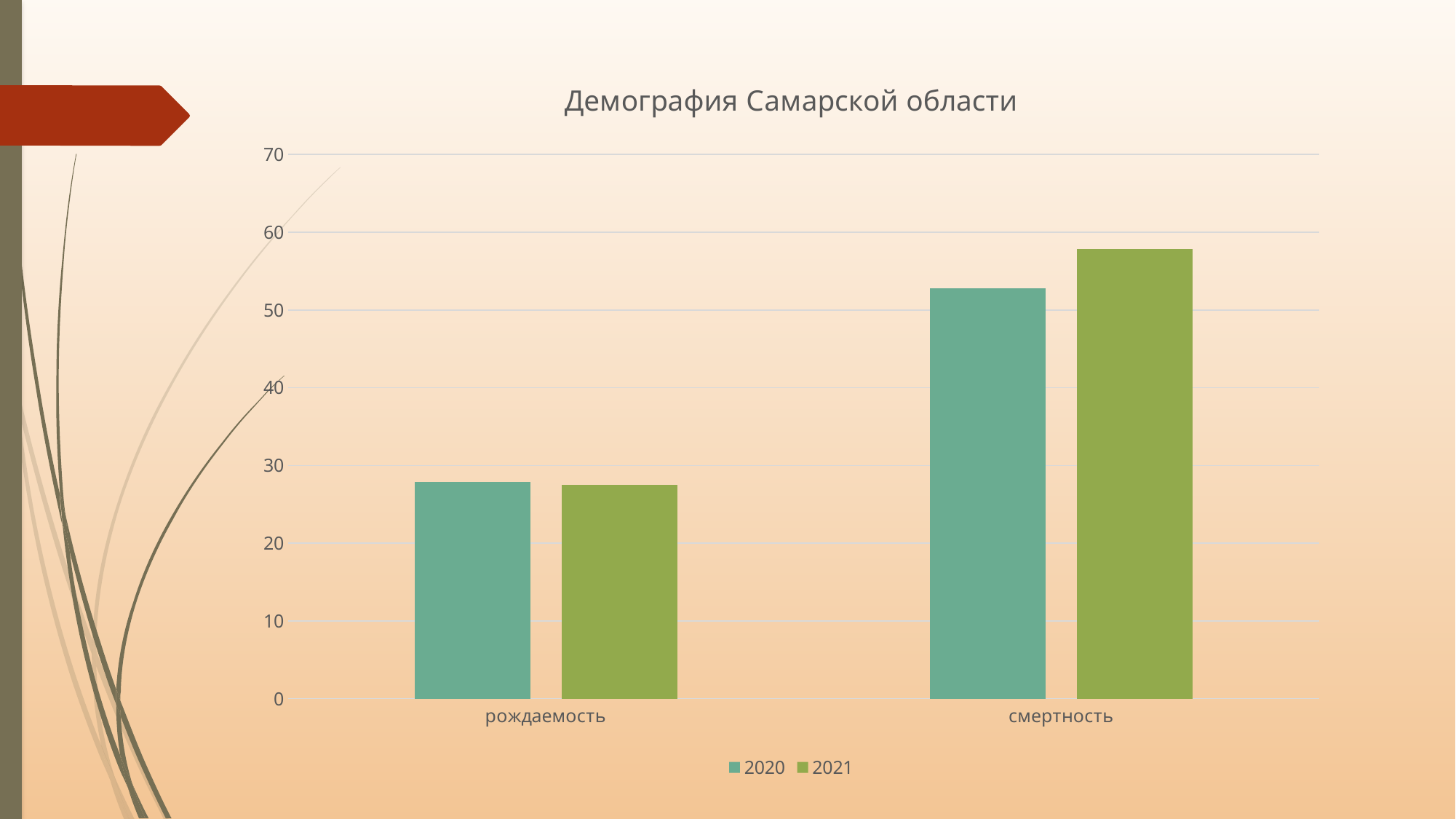
Is the value for рождаемость in 2020 greater or less than 30? less Which category has the highest bar in the chart? смертность Which category has the lowest bar in the chart? рождаемость For смертность, which year has the larger value, 2020 or 2021? 2021 Is the value for смертность in 2021 greater or less than 50? greater How many categories are shown on the x axis? 2 Is the value for рождаемость in 2021 greater or less than 20? greater How many series does the legend list? 2 Which series are listed in the legend? 2020 and 2021 What is the title of the chart? Демография Самарской области What kind of chart is shown on the slide? bar chart